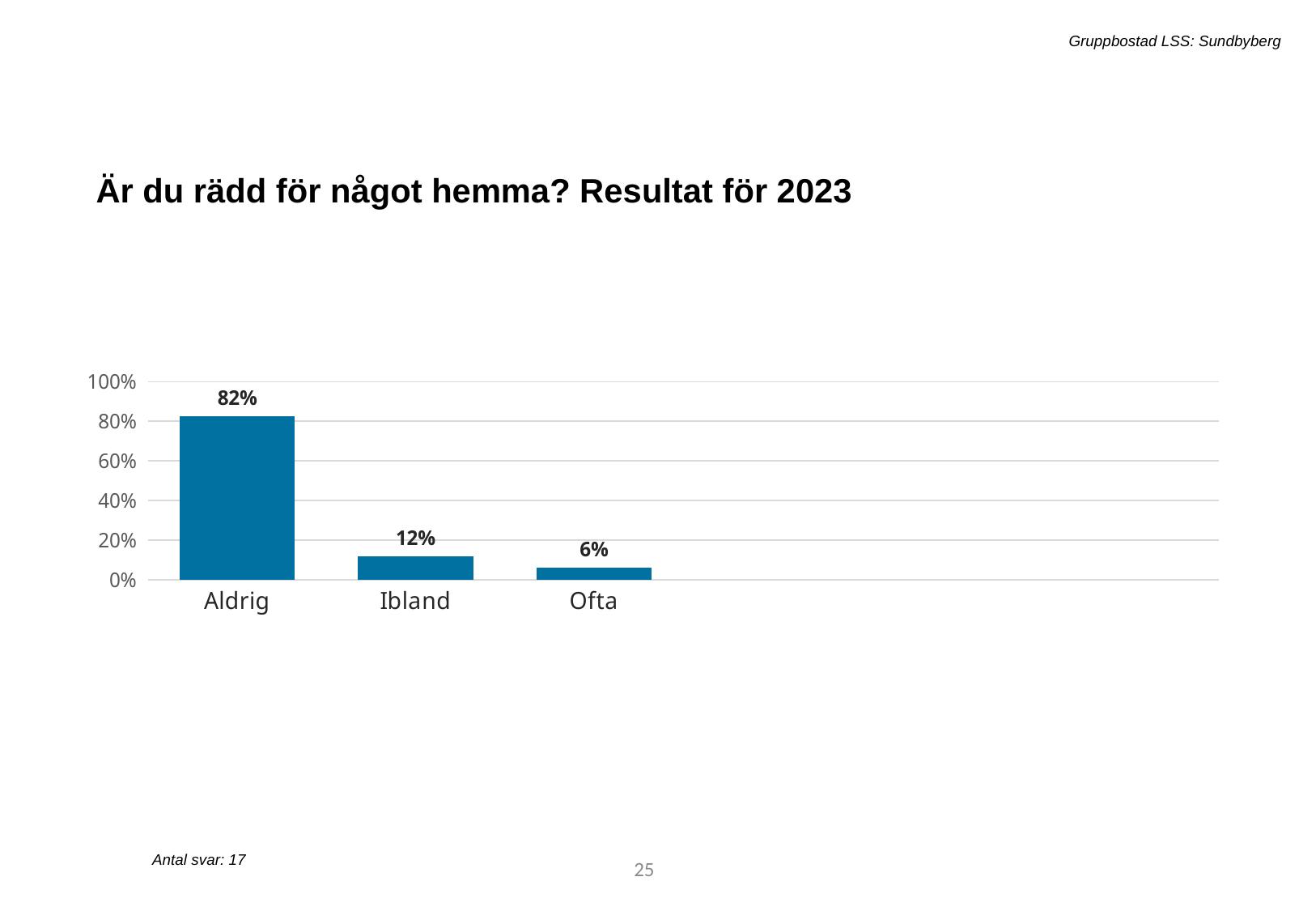
What kind of chart is shown on the slide? Bar chart Is the value for Aldrig greater or less than 60%? greater How many categories are shown on the x axis? 3 What is the value for Aldrig? 82% Which category has the lowest value? Ofta Which is larger, the value for Ibland or the value for Ofta? Ibland What is the difference between the values for Ibland and Ofta? 6% What is the value for Ibland? 12% Which category has the highest value? Aldrig What is the difference between the values for Aldrig and Ibland? 70% What is the value for Ofta? 6% Do the values rise or fall from left to right along the x axis? Fall